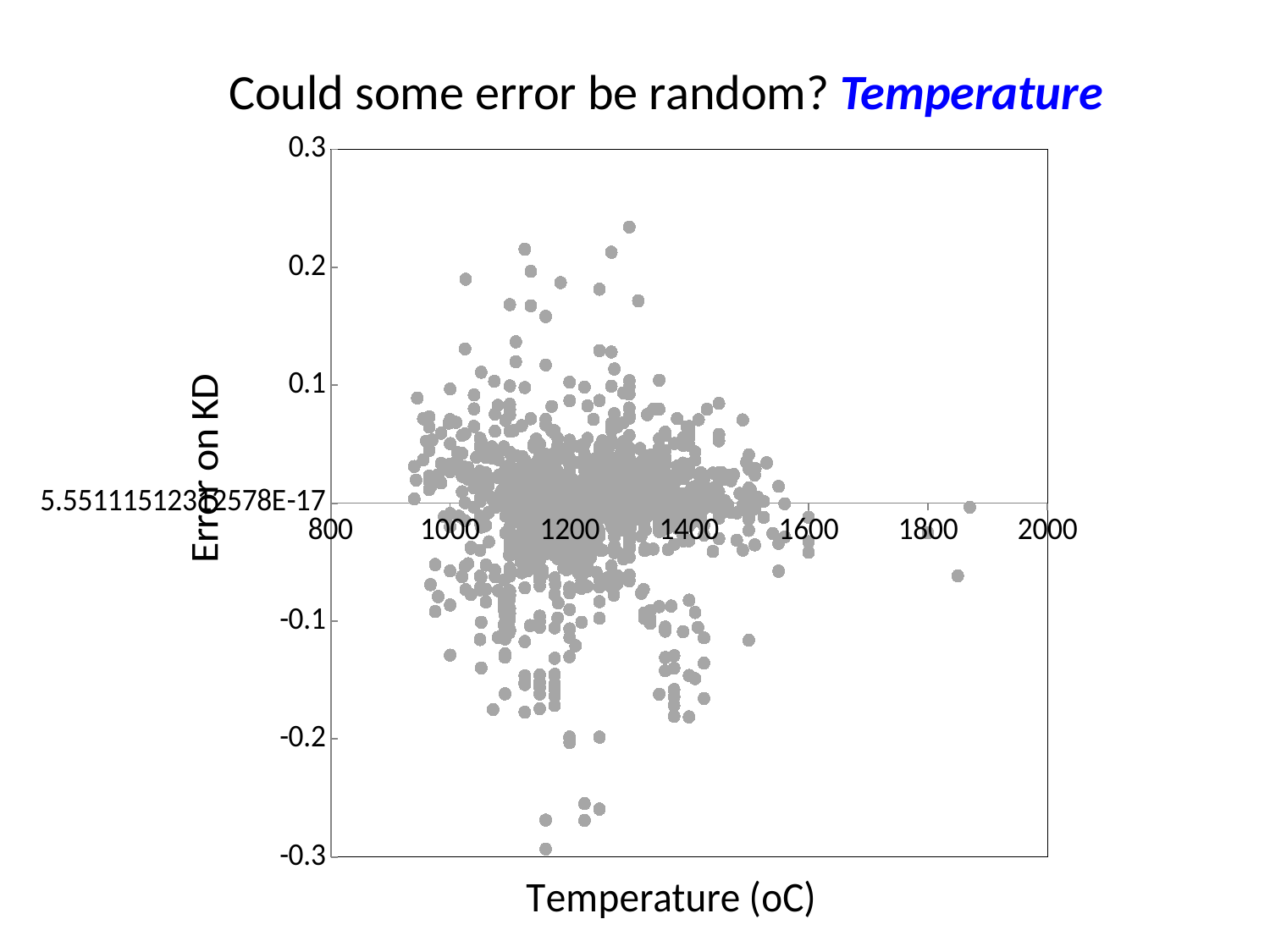
Is the error value of the highest point on the chart greater or less than 0.2? greater Is the temperature of the rightmost point on the chart greater or less than 2000? less What is the title of the x axis? Temperature (oC) What is the title of the y axis? Error on KD Is the temperature of the rightmost point on the chart greater or less than 1800? greater What kind of chart is shown on the slide? scatter plot